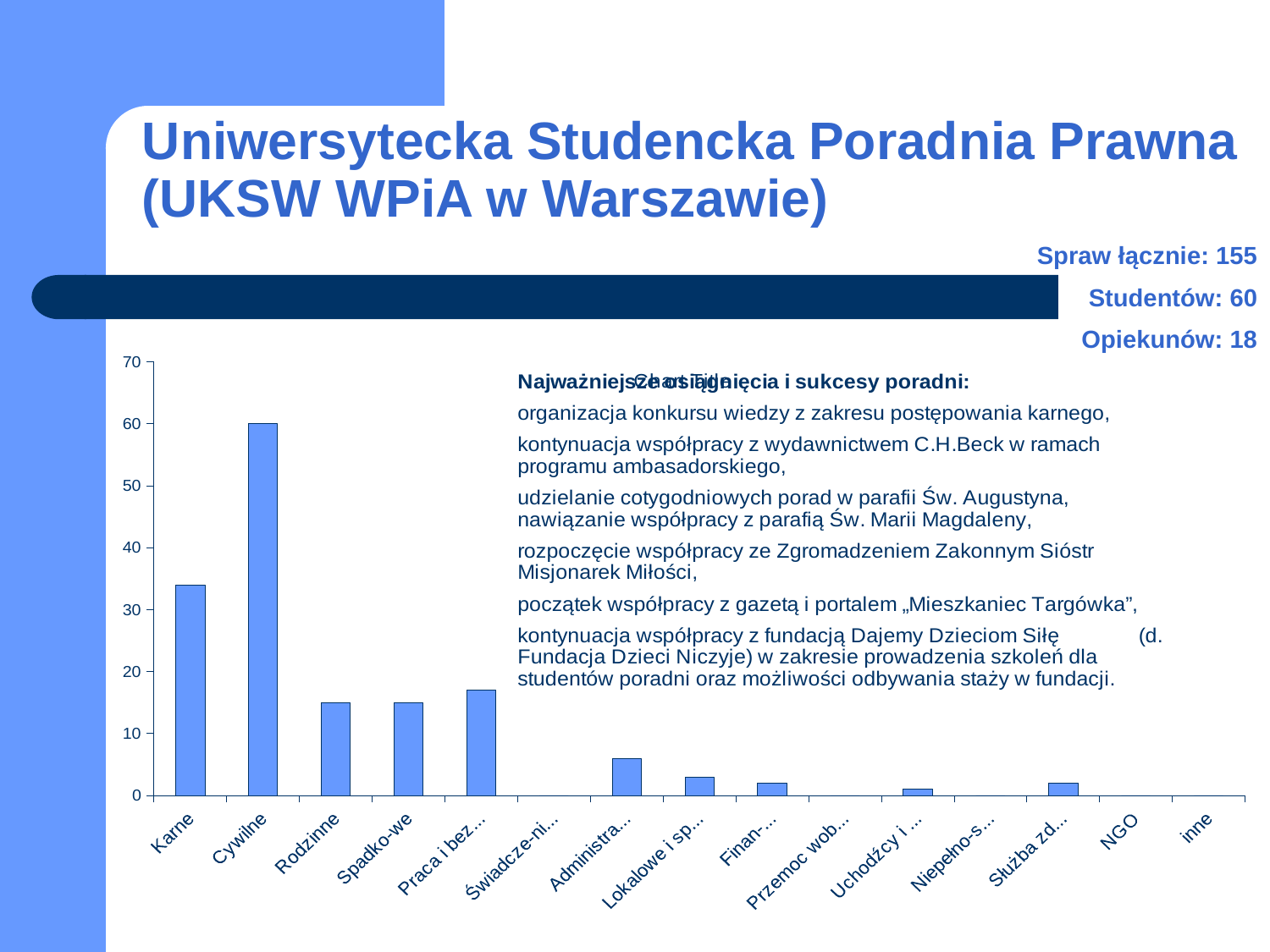
What is the value for Cywilne in the chart? 60 Is the value for Karne greater or less than 30? greater Which is larger, the value for Karne or the value for Cywilne? Cywilne Which is larger, the value for Karne or the value for Rodzinne? Karne Is the value for Praca i bez... greater or less than 20? less What is the highest value shown on the vertical axis of the chart? 70 What kind of chart is shown on the slide? bar chart Is the value for Administra... greater or less than 10? less How many categories are shown on the x axis of the chart? 15 Which category has the highest value in the chart? Cywilne